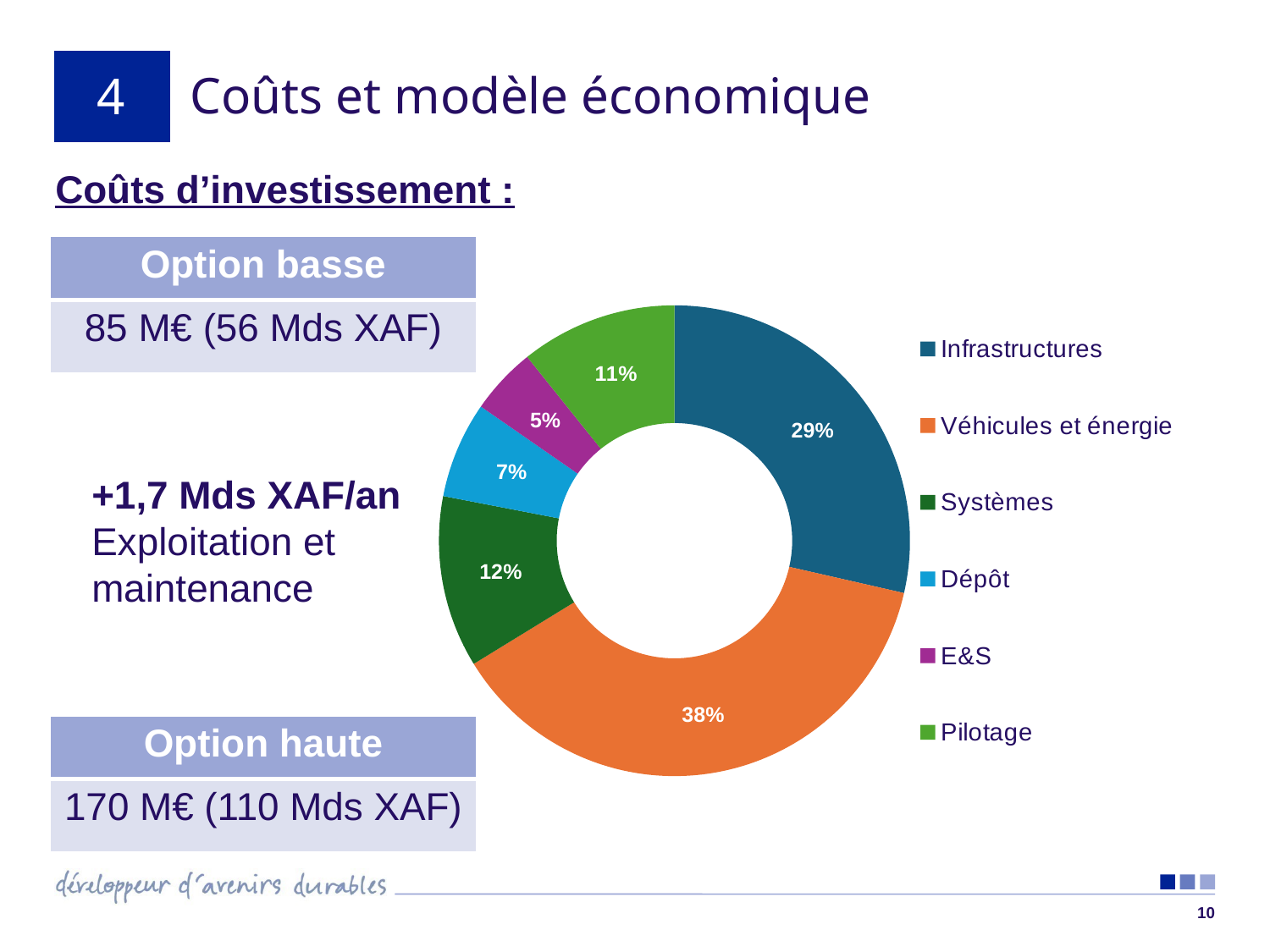
How many categories does the pie chart legend list? 6 What share of the pie chart does Pilotage represent? 11% What is the difference in percentage points between Véhicules et énergie and Infrastructures? 9 percentage points What share of the pie chart does Systèmes represent? 12% Which category has the smallest share of the pie chart? E&S What share of the pie chart does E&S represent? 5% What share of the pie chart does Infrastructures represent? 29% Which category has the largest share of the pie chart? Véhicules et énergie What kind of chart is shown on the slide? Pie chart (donut) Which has a larger share, Systèmes or Pilotage? Systèmes What share of the pie chart does Véhicules et énergie represent? 38% What share of the pie chart does Dépôt represent? 7%